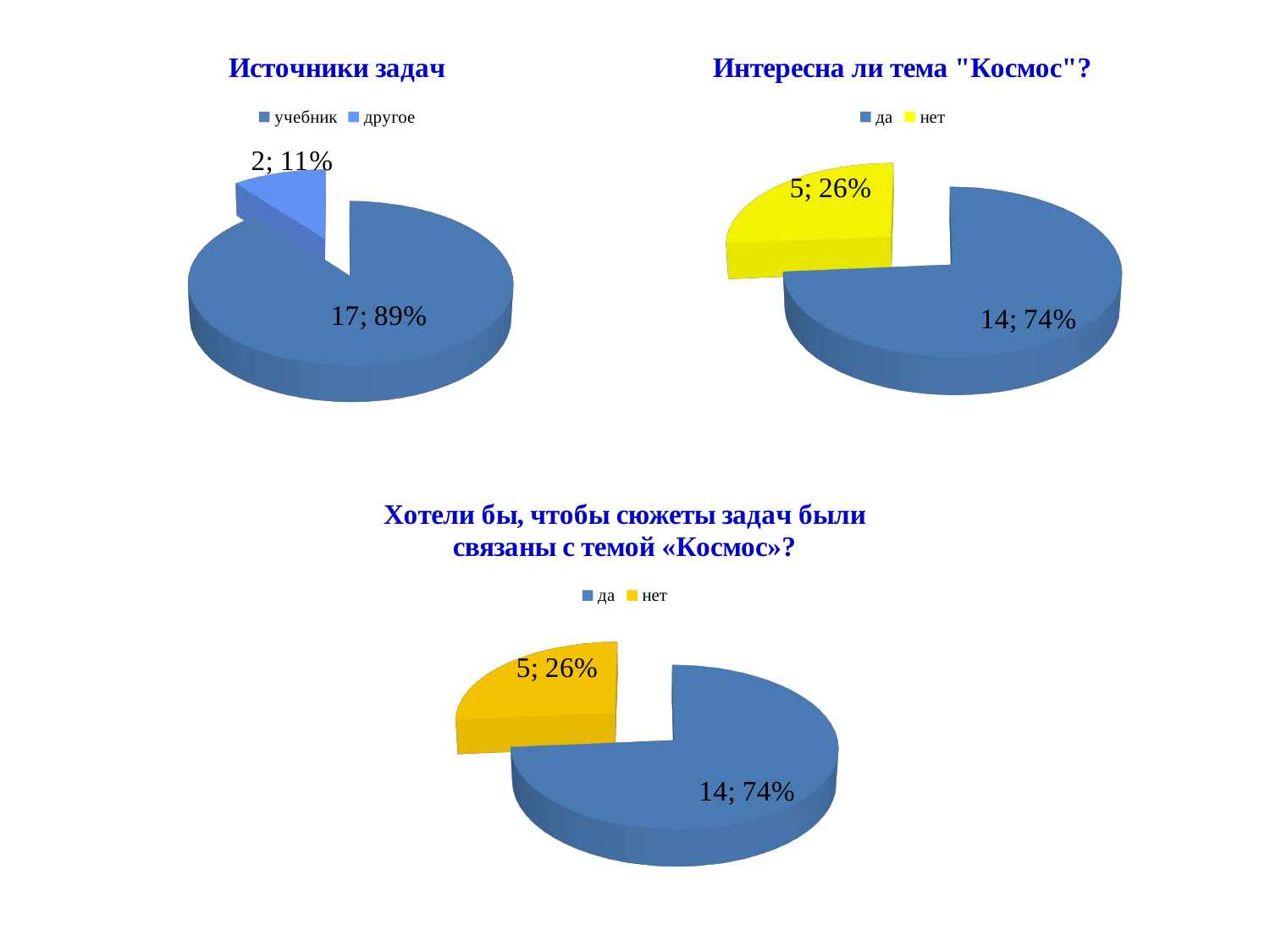
In the "Интересна ли тема "Космос"?" chart, what share of the pie does да take? 74% In the "Интересна ли тема "Космос"?" chart, which category is the smallest? нет What type of chart is the bottom chart ("Хотели бы, чтобы сюжеты задач были связаны с темой «Космос»?")? pie chart In the "Источники задач" chart, what is the difference between the counts for учебник and другое? 15 In the "Источники задач" chart, which category is the largest? учебник In the "Интересна ли тема "Космос"?" chart, what value is shown for нет? 5; 26% In the bottom chart ("Хотели бы, чтобы сюжеты задач были связаны с темой «Космос»?"), which is larger, да or нет? да In the bottom chart ("Хотели бы, чтобы сюжеты задач были связаны с темой «Космос»?"), what value is shown for да? 14; 74% In the "Источники задач" chart, how many slices does the pie have? 2 In the "Источники задач" chart, what value is shown for учебник? 17; 89% In the "Интересна ли тема "Космос"?" chart, what is the total of the two slice counts? 19 In the "Источники задач" chart, what share of the pie does другое take? 11%